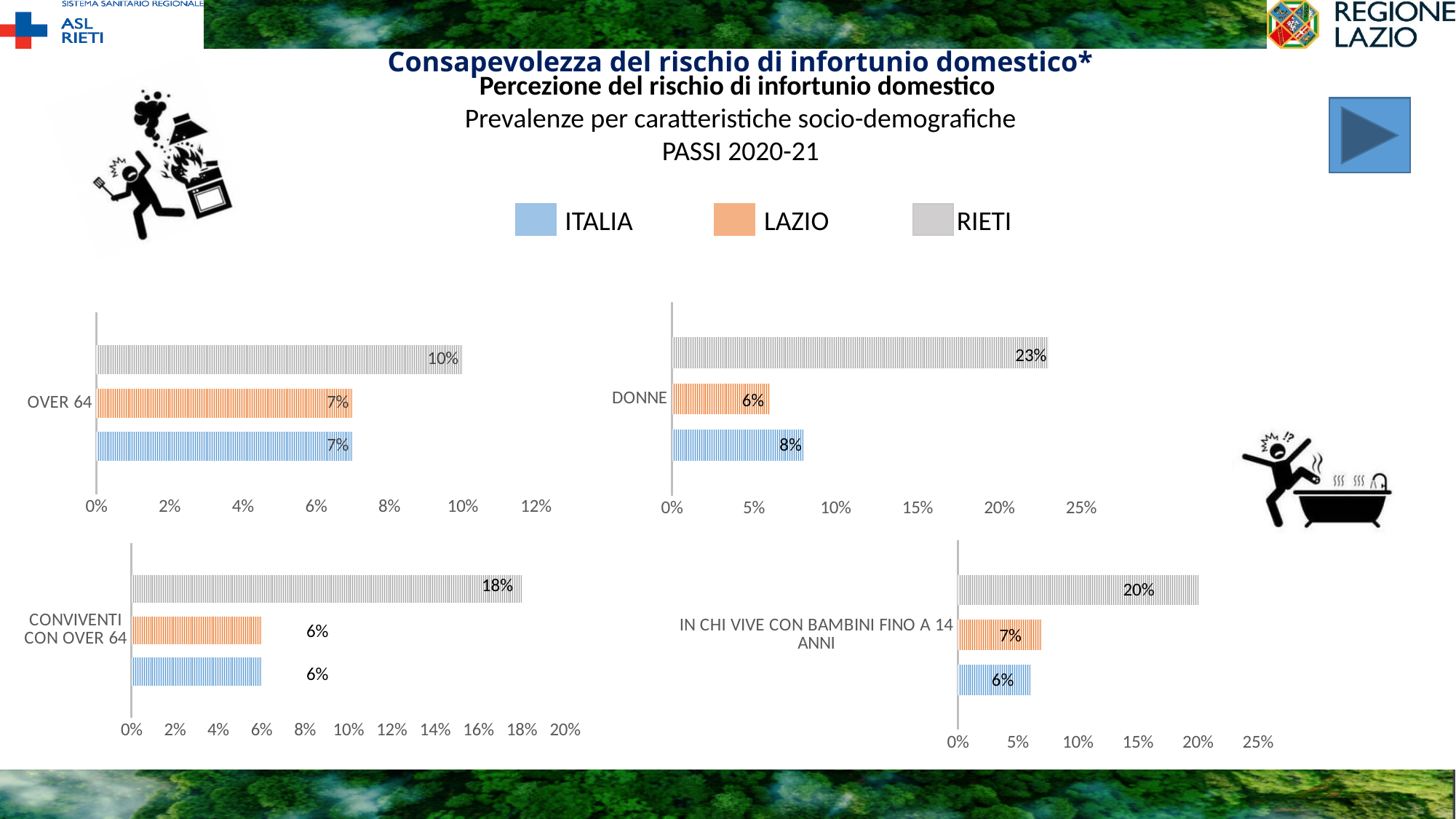
In the CONVIVENTI CON OVER 64 chart, what is the value for RIETI? 18% In the DONNE chart, which series has the lowest value? LAZIO In the CONVIVENTI CON OVER 64 chart, what is the difference between the RIETI value and the LAZIO value? 12% In the DONNE chart, which series has the highest value? RIETI In the OVER 64 chart, what is the value for RIETI? 10% In the IN CHI VIVE CON BAMBINI FINO A 14 ANNI chart, what is the value for LAZIO? 7% In the DONNE chart, what is the difference between the RIETI value and the ITALIA value? 15% How many series does the legend list? 3 In the OVER 64 chart, is the value for RIETI greater or less than 8%? greater In the IN CHI VIVE CON BAMBINI FINO A 14 ANNI chart, which is larger, the value for LAZIO or the value for ITALIA? LAZIO What kind of chart is used for the DONNE data? bar chart In the DONNE chart, what is the value for ITALIA? 8%